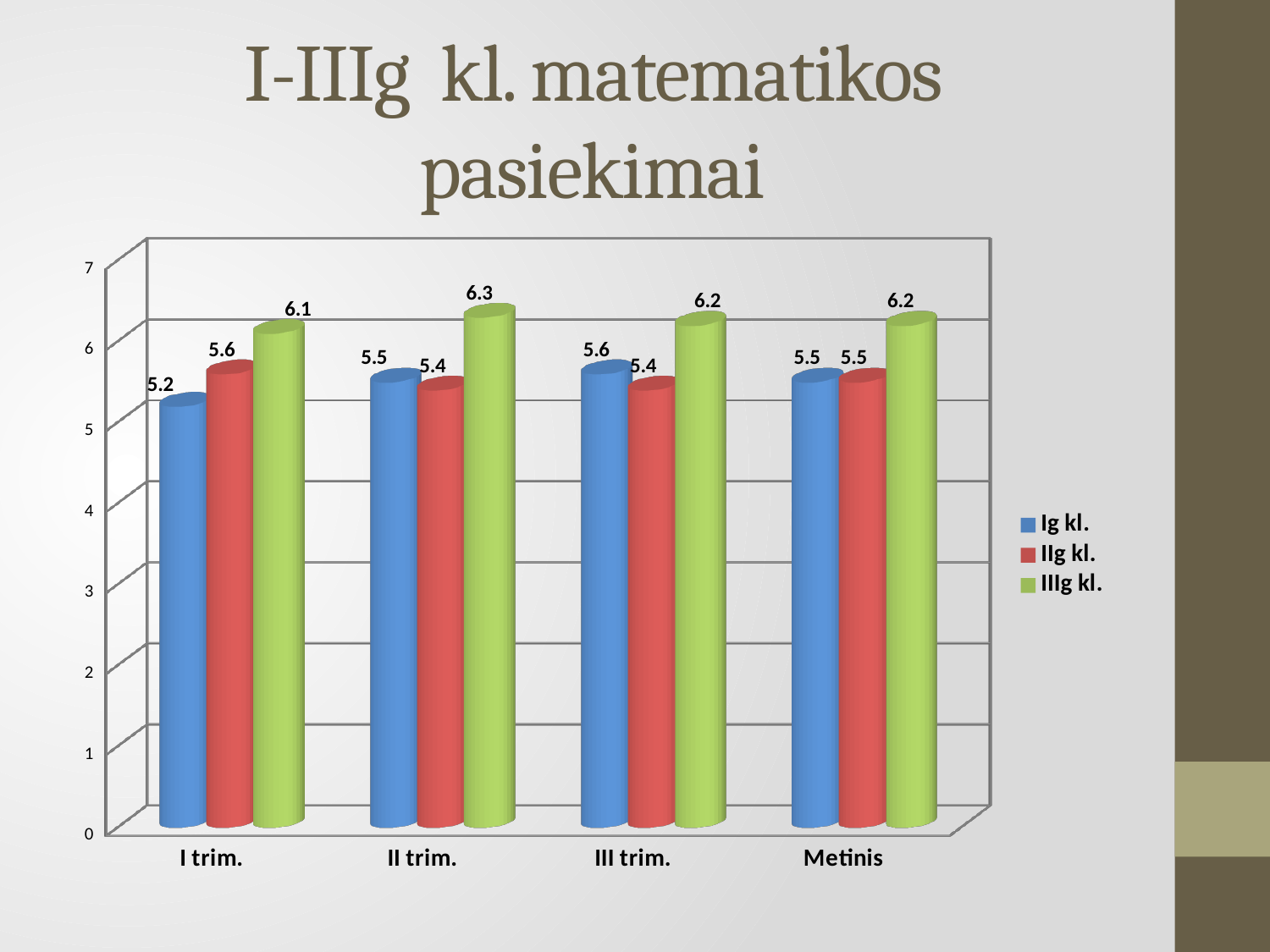
What is the title of the chart? I-IIIg kl. matematikos pasiekimai Which category has the highest value for IIIg kl.? II trim. What is the value for IIg kl. in Metinis? 5.5 Which category has the lowest value for Ig kl.? I trim. What is the value for Ig kl. in I trim.? 5.2 What kind of chart is shown on the slide? bar chart What is the value for IIIg kl. in II trim.? 6.3 How many series does the legend list? 3 Which is larger in III trim., the Ig kl. value or the IIg kl. value? Ig kl. What is the difference between the IIIg kl. and Ig kl. values in I trim.? 0.9 Is the value for IIIg kl. in III trim. greater or less than 6? greater How many categories are shown on the x axis? 4